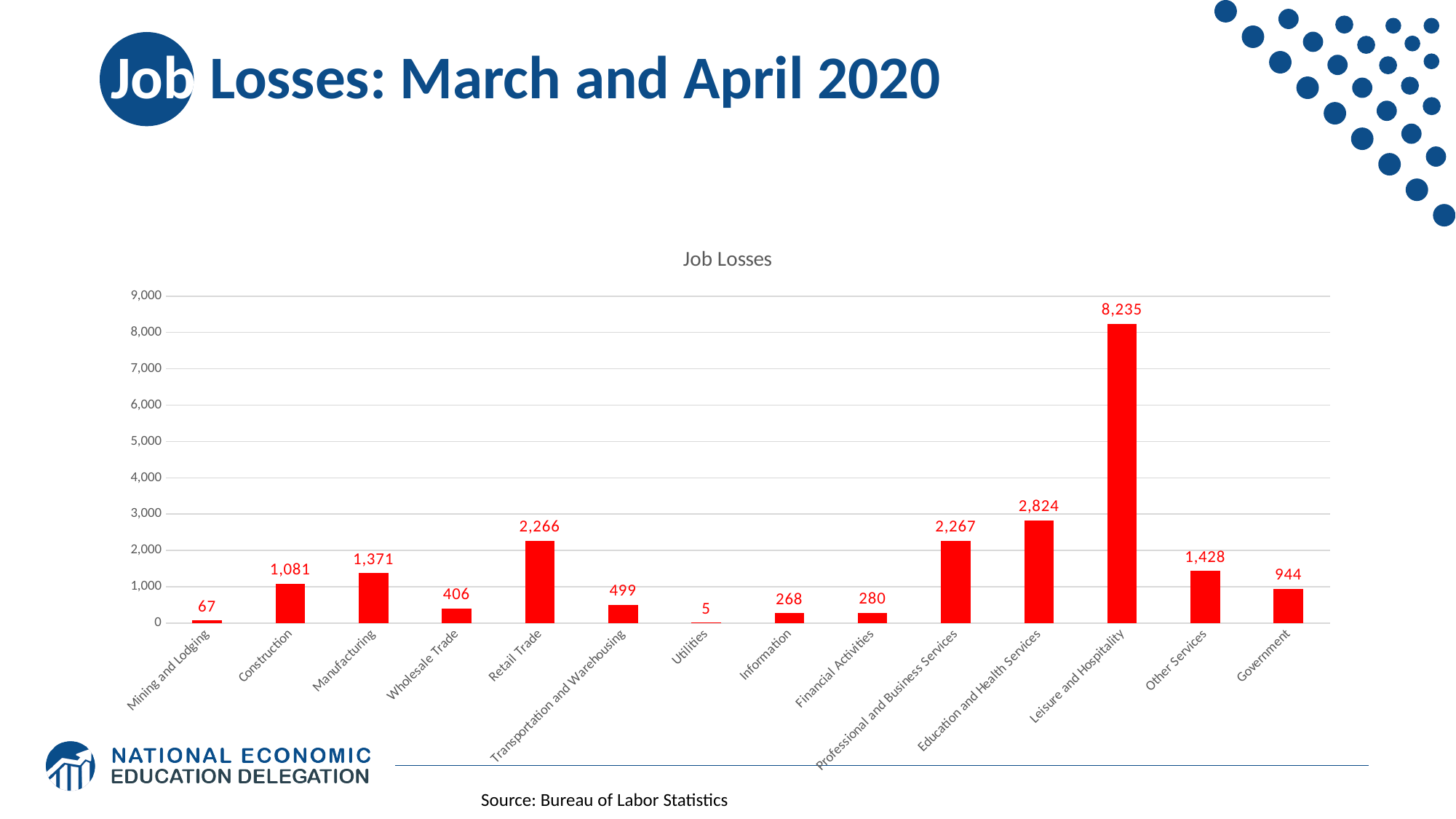
What is the value for Leisure and Hospitality? 8,235 Is the value for Other Services greater or less than 1,000? greater What is the value for Retail Trade? 2,266 What kind of chart is this? bar chart What colour are the bars? red How many categories are shown on the x axis? 14 Which category has the lowest value? Utilities What is the difference between Education and Health Services and Professional and Business Services? 557 Which category has the highest value? Leisure and Hospitality What is the title of the chart? Job Losses Which is larger, Manufacturing or Construction? Manufacturing What is the value for Government? 944